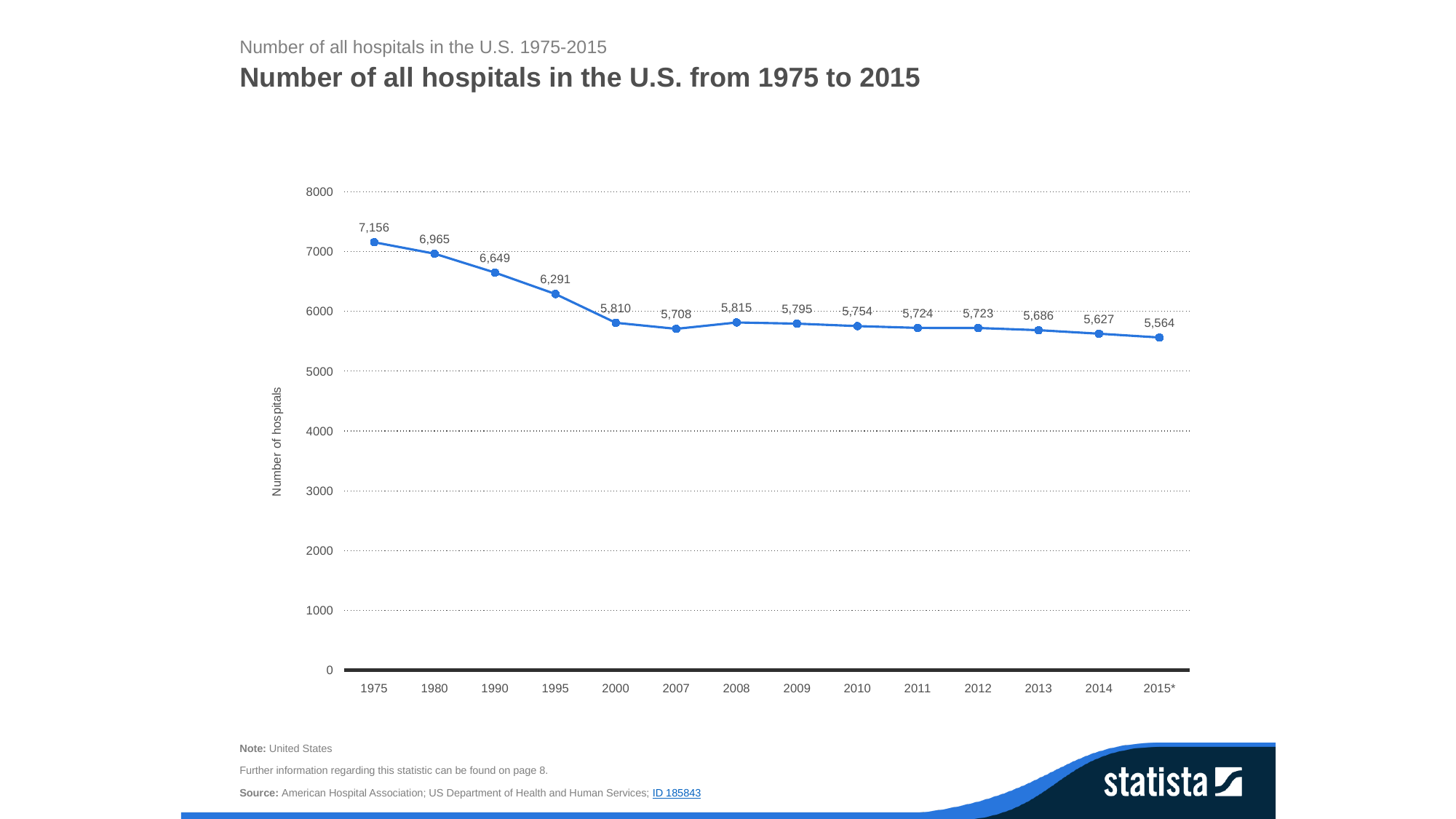
What kind of chart is shown on the slide? Line chart Is the value for 1995 greater or less than 6000? greater What is the number of hospitals shown for 2015*? 5,564 How many years are plotted on the x axis? 14 Which year has more hospitals, 1990 or 2000? 1990 What is the difference between the number of hospitals in 1975 and in 2015*? 1,592 What is the label of the y axis? Number of hospitals How many hospitals were there in the U.S. in 1975? 7,156 What is the value for 2007? 5,708 What is the overall trend in the number of hospitals from 1975 to 2015? Falling Which year has the lowest number of hospitals? 2015* Which year has the highest number of hospitals? 1975